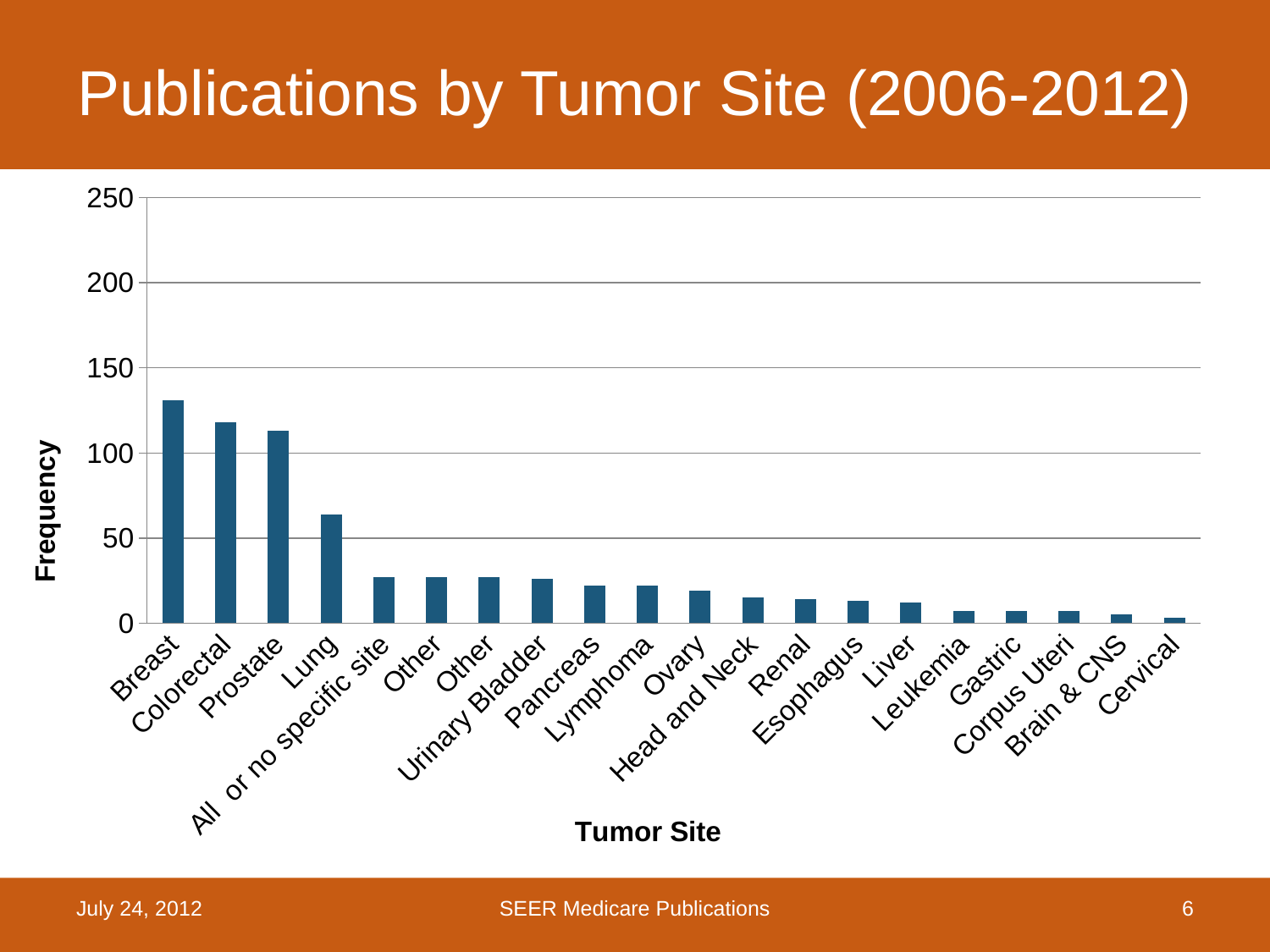
Is the value for Breast greater or less than 100? greater Is the value for Lung greater or less than 50? greater How many tumor site categories are shown on the x axis? 20 What type of chart is shown on the slide? Bar chart Do the values generally rise or fall moving from left to right along the x axis? Fall Is the value for Lung greater or less than 100? less Which tumor site has the lowest frequency of publications? Cervical Which tumor site has the highest frequency of publications? Breast What is the label of the y axis? Frequency Which has a higher frequency, Ovary or Renal? Ovary Which has a higher frequency, Lung or Pancreas? Lung